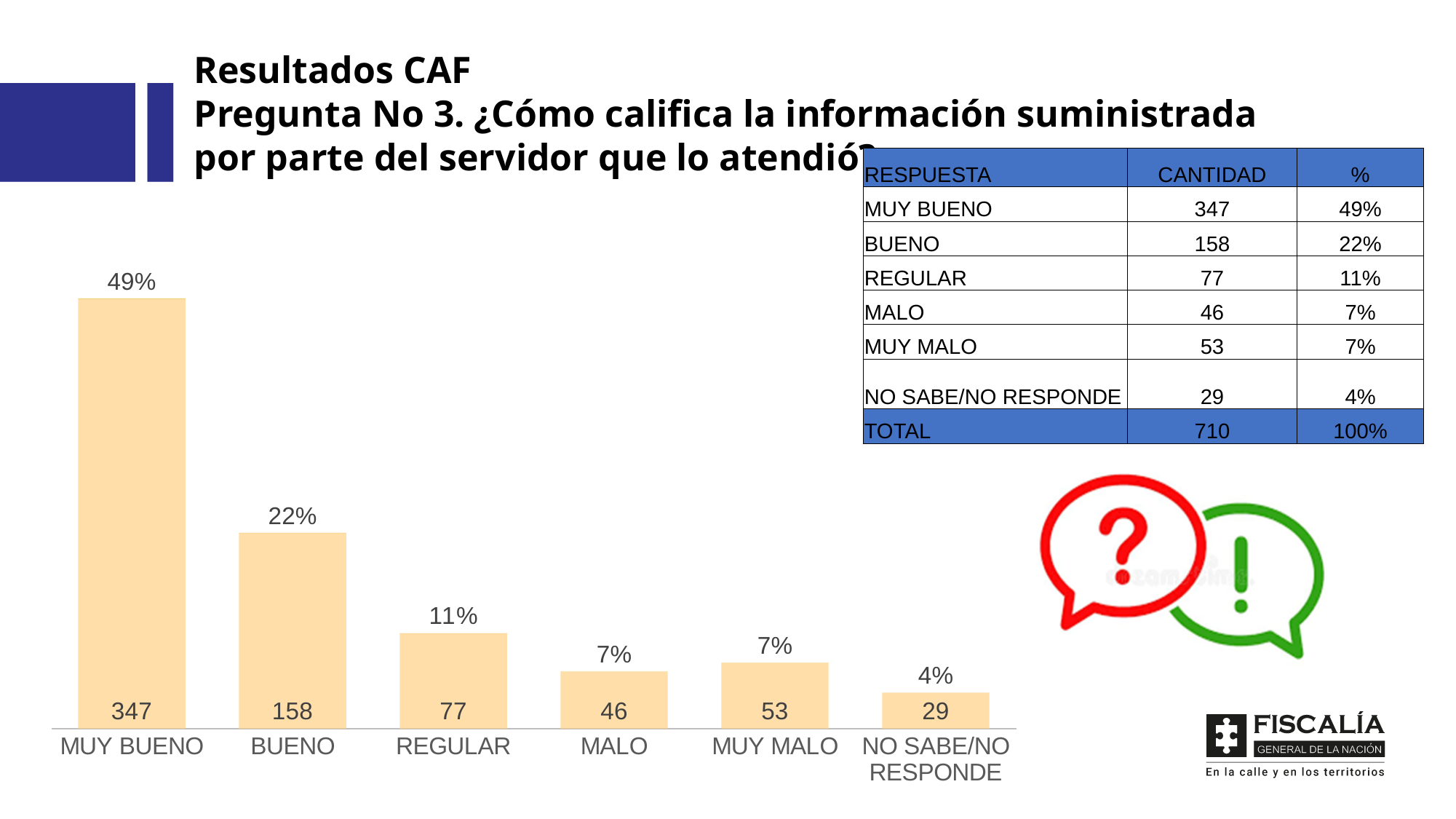
How many categories are shown on the x axis of the bar chart? 6 What count is shown inside the bar for REGULAR? 77 Which category has the lowest bar? NO SABE/NO RESPONDE What colour are the bars in the chart? light orange What count is shown for NO SABE/NO RESPONDE? 29 What is the difference in count between MUY BUENO and BUENO? 189 What kind of chart is shown on the slide? bar chart Do the bar values generally rise or fall from left to right across the chart? fall What is the difference in count between MUY MALO and MALO? 7 Which category has the highest bar? MUY BUENO Which has a larger count, BUENO or REGULAR? BUENO What percentage is shown for MUY BUENO in the bar chart? 49%